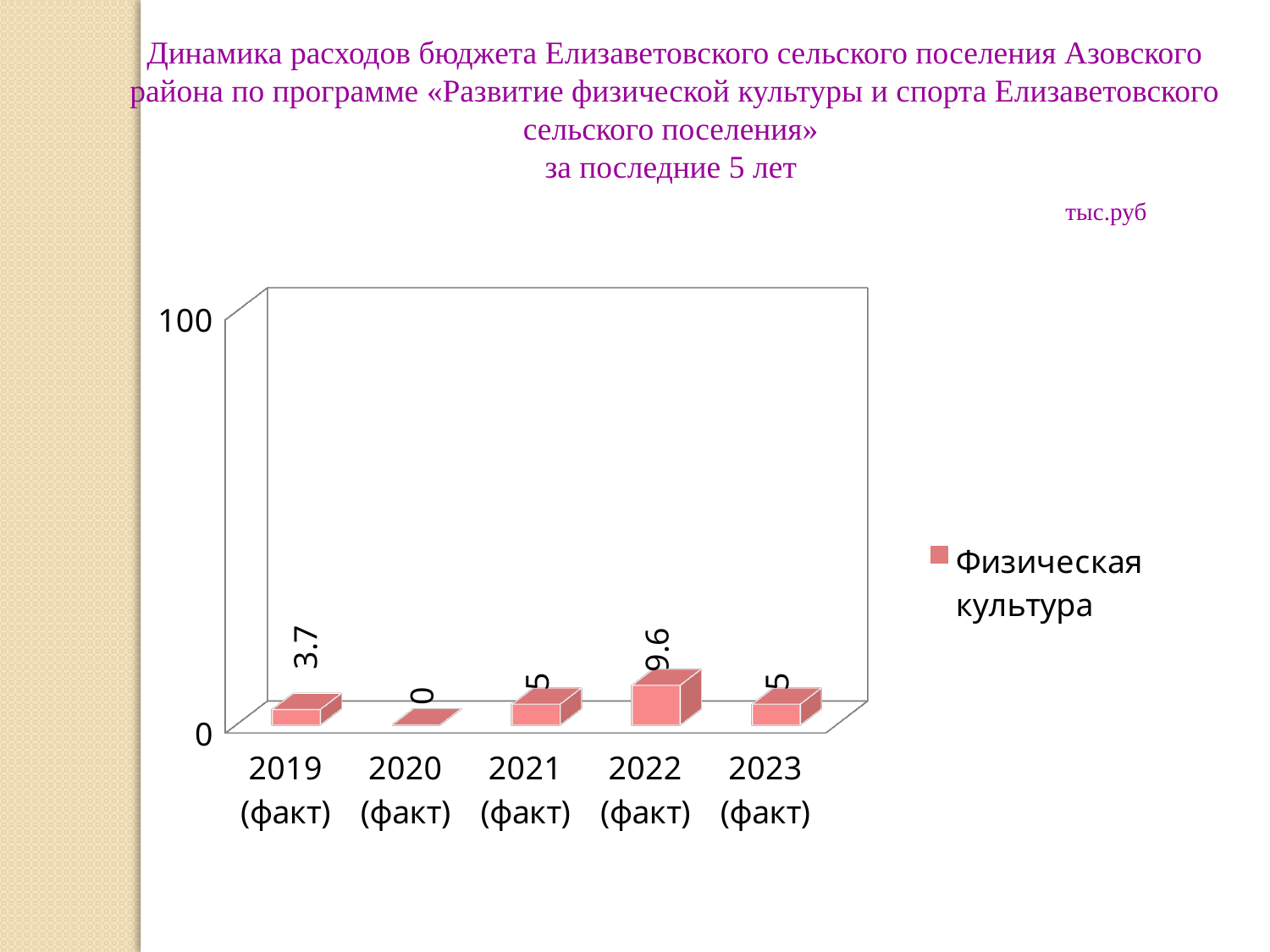
What is the value for 2022 (факт)? 9.6 How many categories are shown on the x axis? 5 What kind of chart is shown on the slide? bar chart What is the value for 2019 (факт)? 3.7 Which is larger, the value for 2021 (факт) or the value for 2019 (факт)? 2021 (факт) What is the value for 2023 (факт)? 5 How many series does the legend list? 1 What is the difference between the values for 2022 (факт) and 2019 (факт)? 5.9 Which year has the highest value? 2022 (факт) Which year has the lowest value? 2020 (факт) What is the value for 2020 (факт)? 0 What series name is shown in the legend? Физическая культура